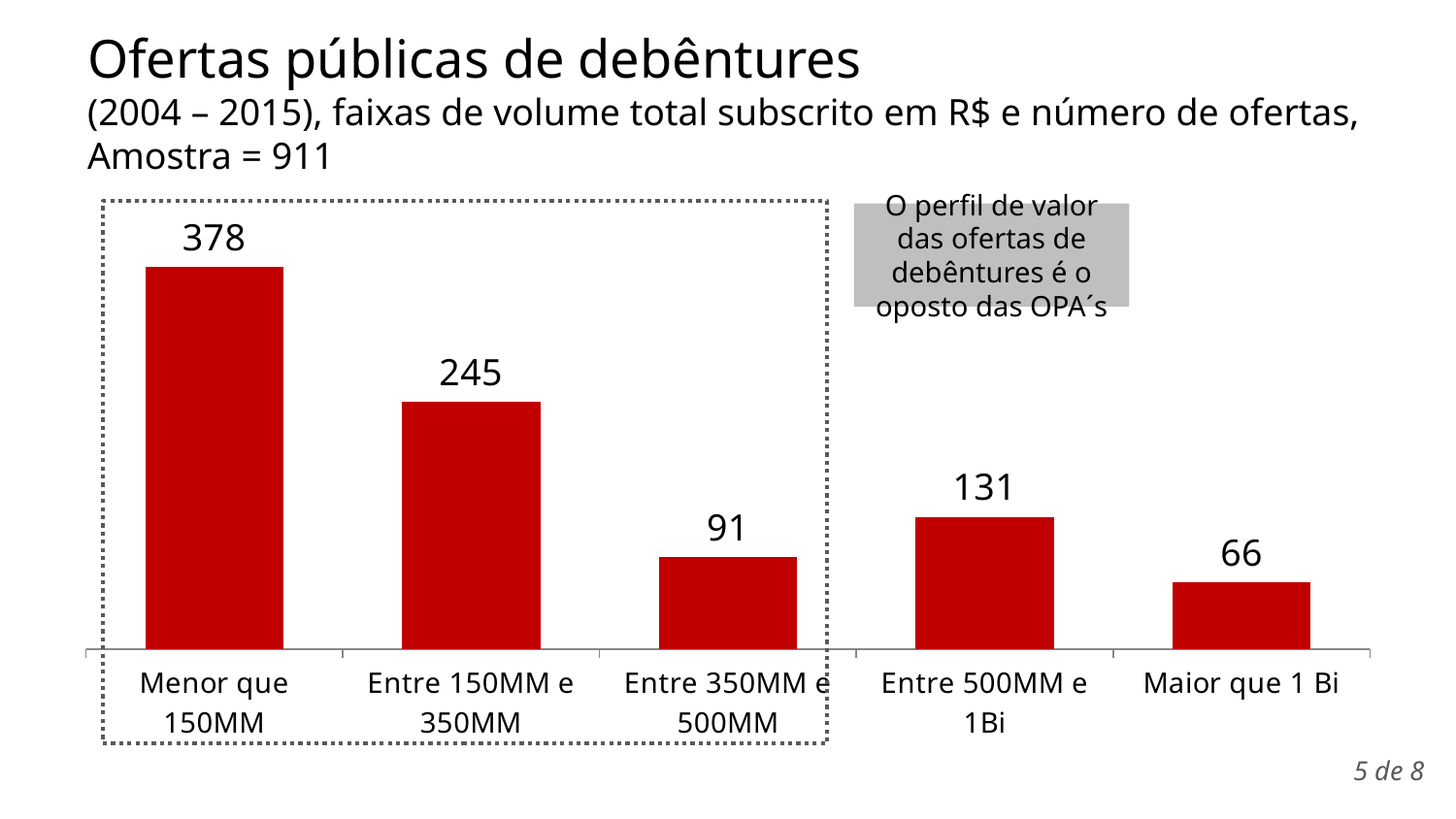
What kind of chart is shown on the slide? Bar chart Which category has the highest number of offerings? Menor que 150MM Which is larger: the value for 'Entre 350MM e 500MM' or the value for 'Entre 500MM e 1Bi'? Entre 500MM e 1Bi How many categories are shown on the x axis? 5 What is the value shown for 'Entre 350MM e 500MM'? 91 Which category has the lowest number of offerings? Maior que 1 Bi What is the number of offerings for the 'Menor que 150MM' category? 378 What is the sample size (Amostra) stated in the chart title? 911 What is the value shown for 'Maior que 1 Bi'? 66 What is the difference between the values for 'Menor que 150MM' and 'Entre 150MM e 350MM'? 133 What is the value shown for 'Entre 500MM e 1Bi'? 131 What is the value shown for 'Entre 150MM e 350MM'? 245